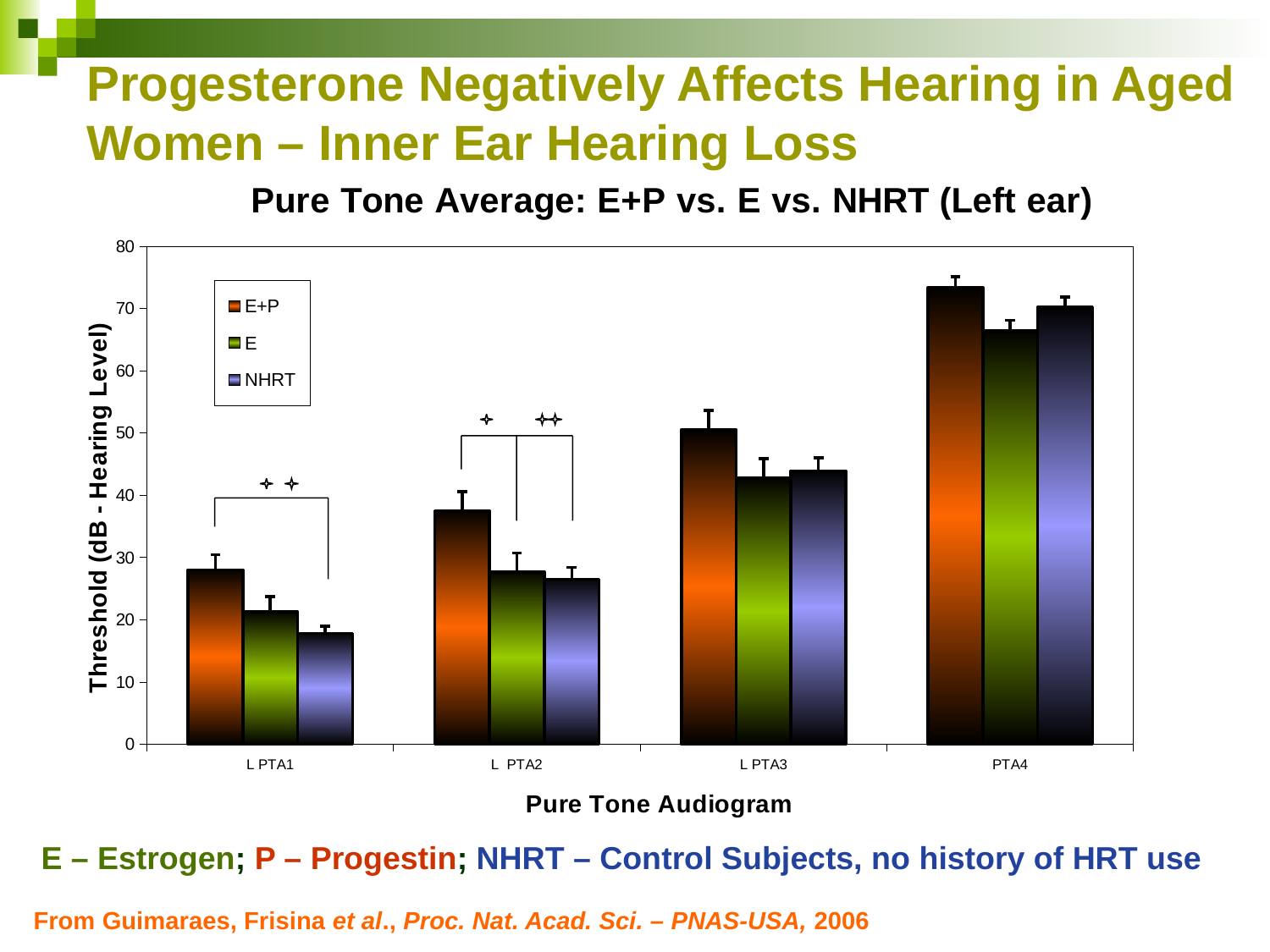
What kind of chart is shown on the slide? bar chart Which category has the highest E+P value? PTA4 How many series does the legend list? 3 What is the title of the chart? Pure Tone Average: E+P vs. E vs. NHRT (Left ear) Is the E value for L PTA1 greater or less than 30? less Which category has the lowest NHRT value? L PTA1 Is the E+P value for PTA4 greater or less than 60? greater Do the E+P values rise or fall from L PTA1 to PTA4? rise Is the E+P value for L PTA1 greater or less than 20? greater How many categories are shown on the x axis? 4 Which is larger at L PTA2, the E+P value or the E value? E+P